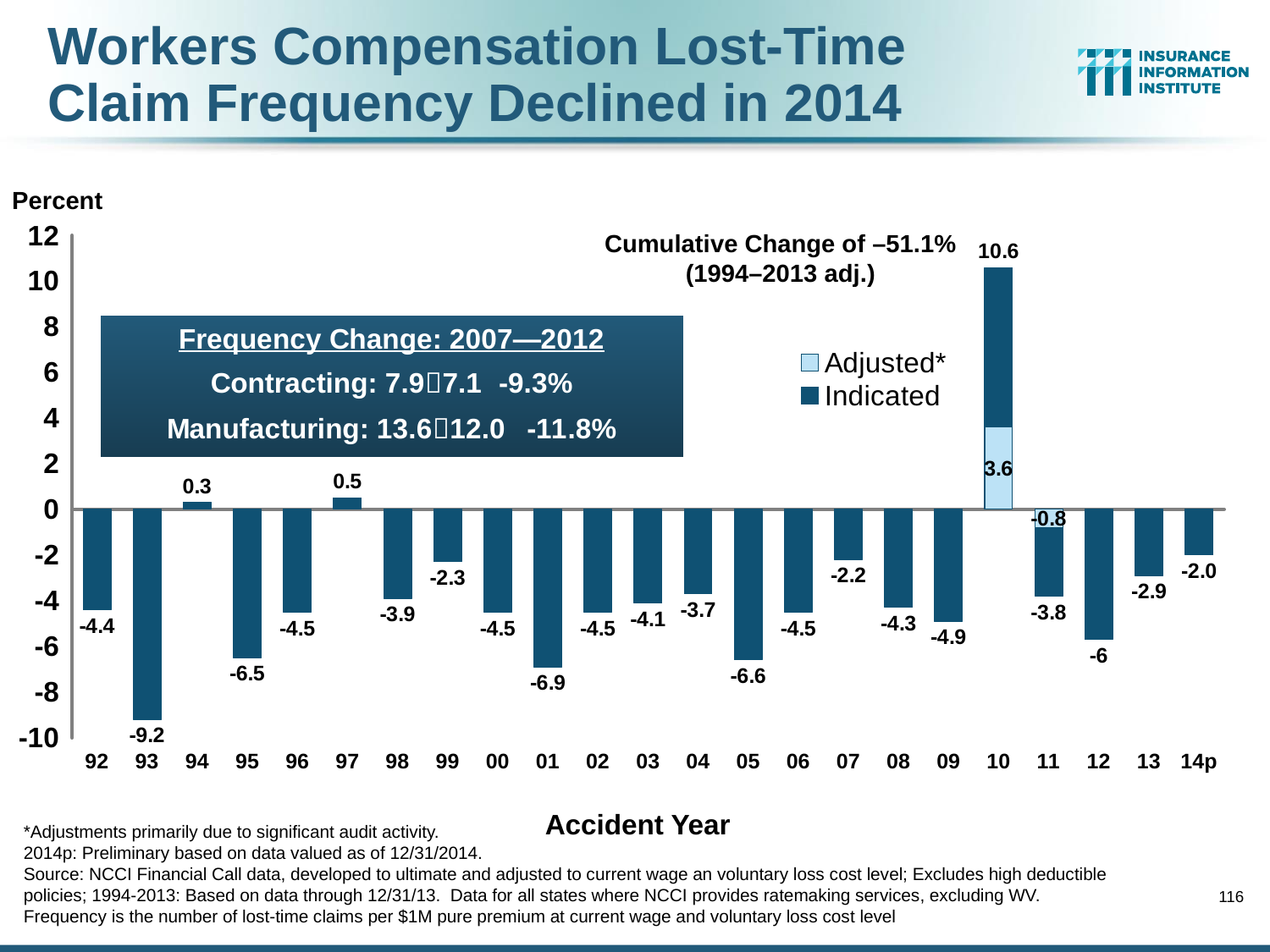
What cumulative change does the chart annotation report for 1994–2013 (adj.)? –51.1% How many accident years are shown on the x axis? 23 Which is larger, the value for accident year 01 or the value for accident year 05? 05 What is the difference between the values for accident years 12 and 13? 3.1 What kind of chart is shown on the slide? Bar chart How many series does the legend list? 2 What is the value for accident year 14p? -2.0 Which accident year has the highest value on the chart? 10 What is the indicated value for accident year 10? 10.6 What is the adjusted value for accident year 10? 3.6 Which accident year has the lowest value on the chart? 93 What is the indicated value for accident year 93? -9.2